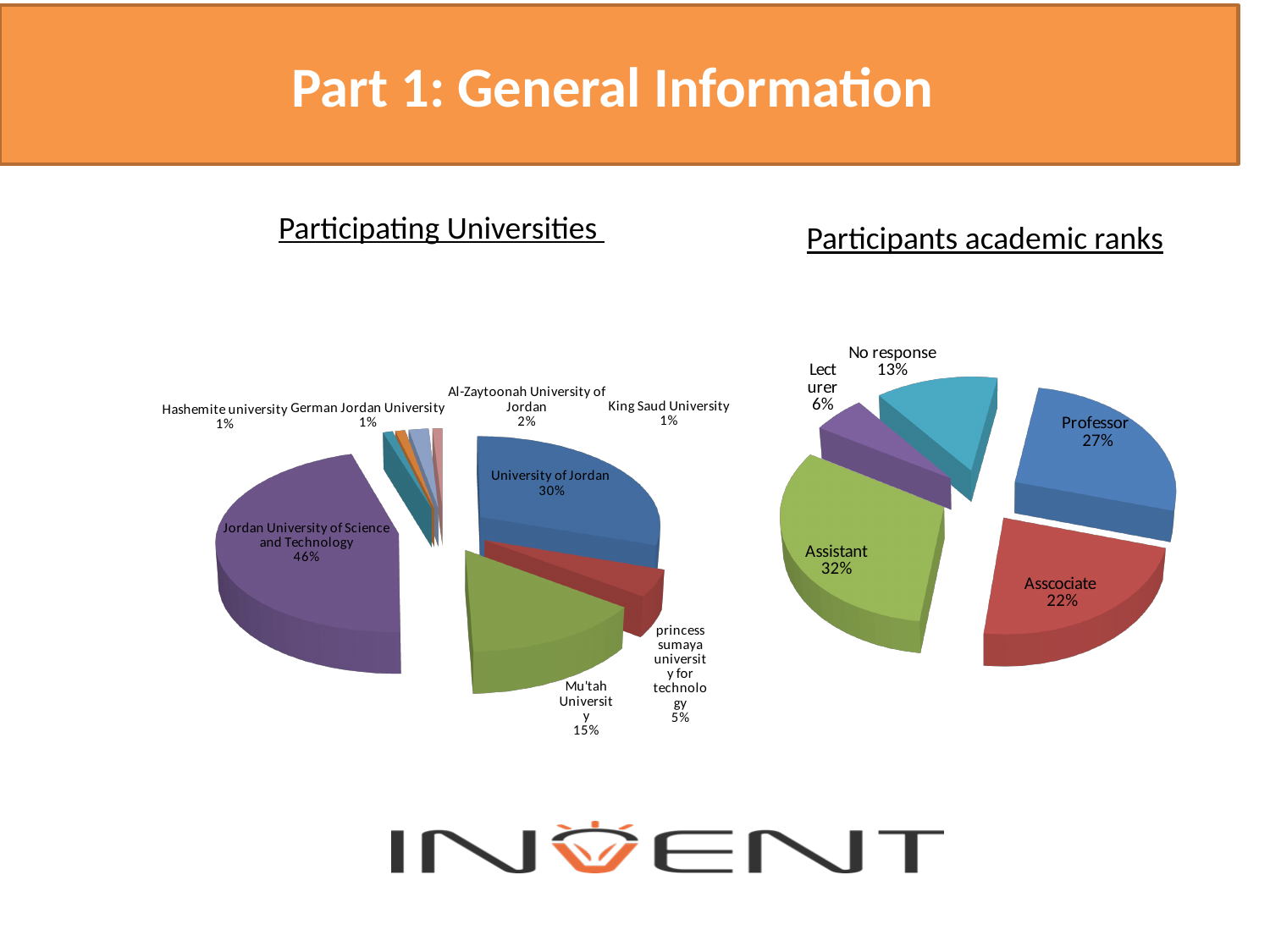
In the Participating Universities chart, what is the difference between the shares of University of Jordan and Mu'tah University? 15% In the Participating Universities chart, how many universities are shown? 8 In the Participating Universities chart, which university has the largest share? Jordan University of Science and Technology In the Participating Universities chart, what share does Al-Zaytoonah University of Jordan have? 2% What type of chart is the Participants academic ranks chart? Pie chart In the Participants academic ranks chart, which is larger, Professor or Associate? Professor In the Participants academic ranks chart, how many categories are shown? 5 In the Participants academic ranks chart, what share is Assistant? 32% In the Participating Universities chart, what share does Jordan University of Science and Technology have? 46% In the Participants academic ranks chart, which rank has the smallest share? Lecturer In the Participating Universities chart, what share does Mu'tah University have? 15% In the Participants academic ranks chart, what is the difference between the Assistant and No response shares? 19%